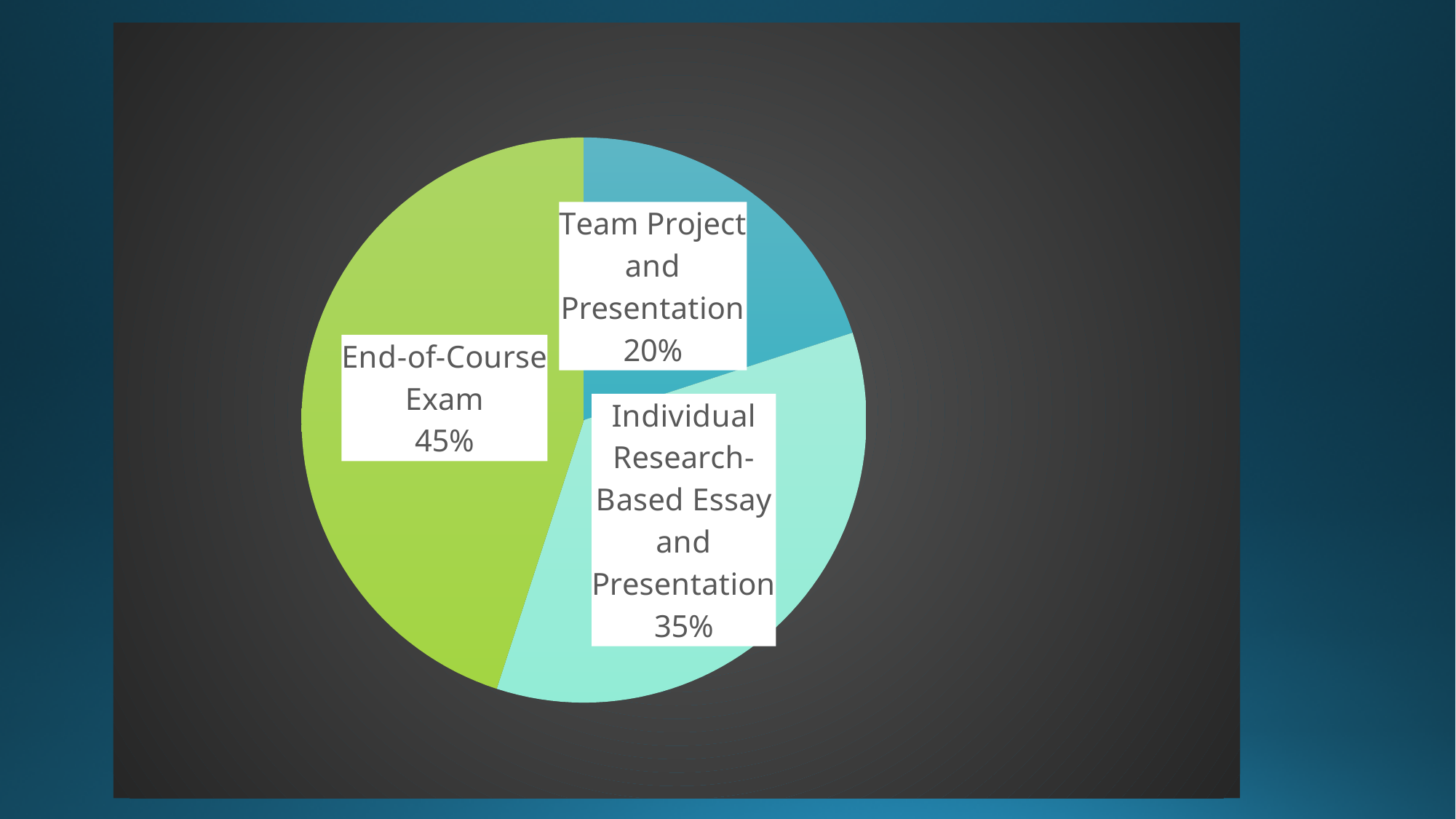
What kind of chart is shown on the slide? Pie chart Which slice of the pie is the largest? End-of-Course Exam How many slices does the pie chart have? 3 What colour is the End-of-Course Exam slice? Green Which slice of the pie is the smallest? Team Project and Presentation What share of the pie does End-of-Course Exam take? 45% Which is larger: the Individual Research-Based Essay and Presentation share or the Team Project and Presentation share? Individual Research-Based Essay and Presentation What is the difference between the End-of-Course Exam share and the Team Project and Presentation share? 25% What is the difference between the End-of-Course Exam share and the Individual Research-Based Essay and Presentation share? 10% What is the combined share of Team Project and Presentation and Individual Research-Based Essay and Presentation? 55% What share of the pie does Team Project and Presentation take? 20% What share of the pie does Individual Research-Based Essay and Presentation take? 35%